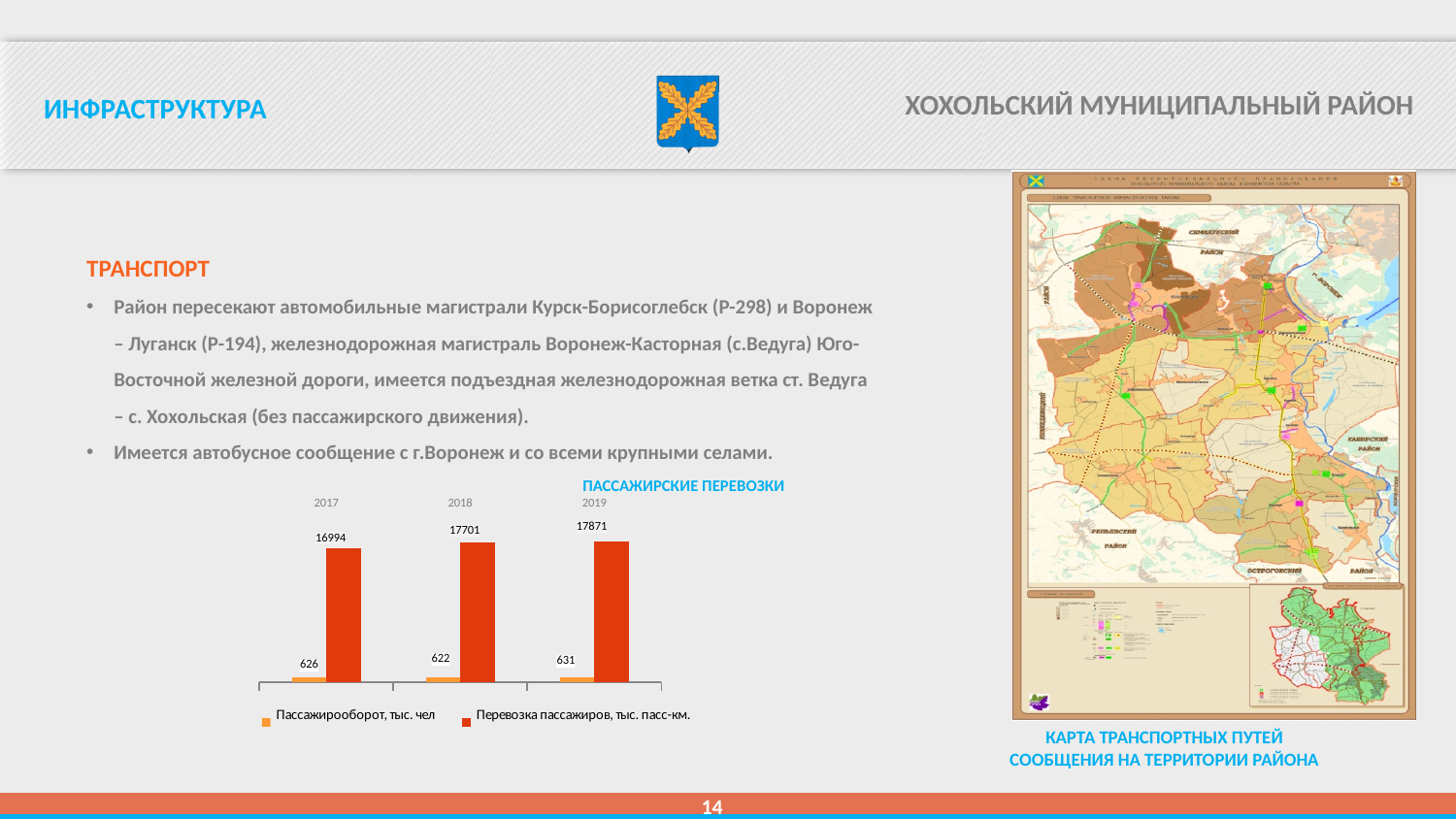
How many years are shown on the x axis of the chart? 3 What is the value of the red series (Перевозка пассажиров, тыс. пасс-км.) for 2019? 17871 What is the value of the orange series (Пассажирооборот, тыс. чел) for 2018? 622 How many series does the chart legend list? 2 Which is larger: the orange series value for 2017 or for 2019? 2019 In which year is the red series (Перевозка пассажиров, тыс. пасс-км.) highest? 2019 What is the value of the orange series (Пассажирооборот, тыс. чел) for 2019? 631 What type of chart is shown on the slide? Bar chart What is the difference between the red series values for 2019 and 2017? 877 What is the value of the red series (Перевозка пассажиров, тыс. пасс-км.) for 2017? 16994 What is the difference between the red series values for 2018 and 2017? 707 In which year is the orange series (Пассажирооборот, тыс. чел) lowest? 2018